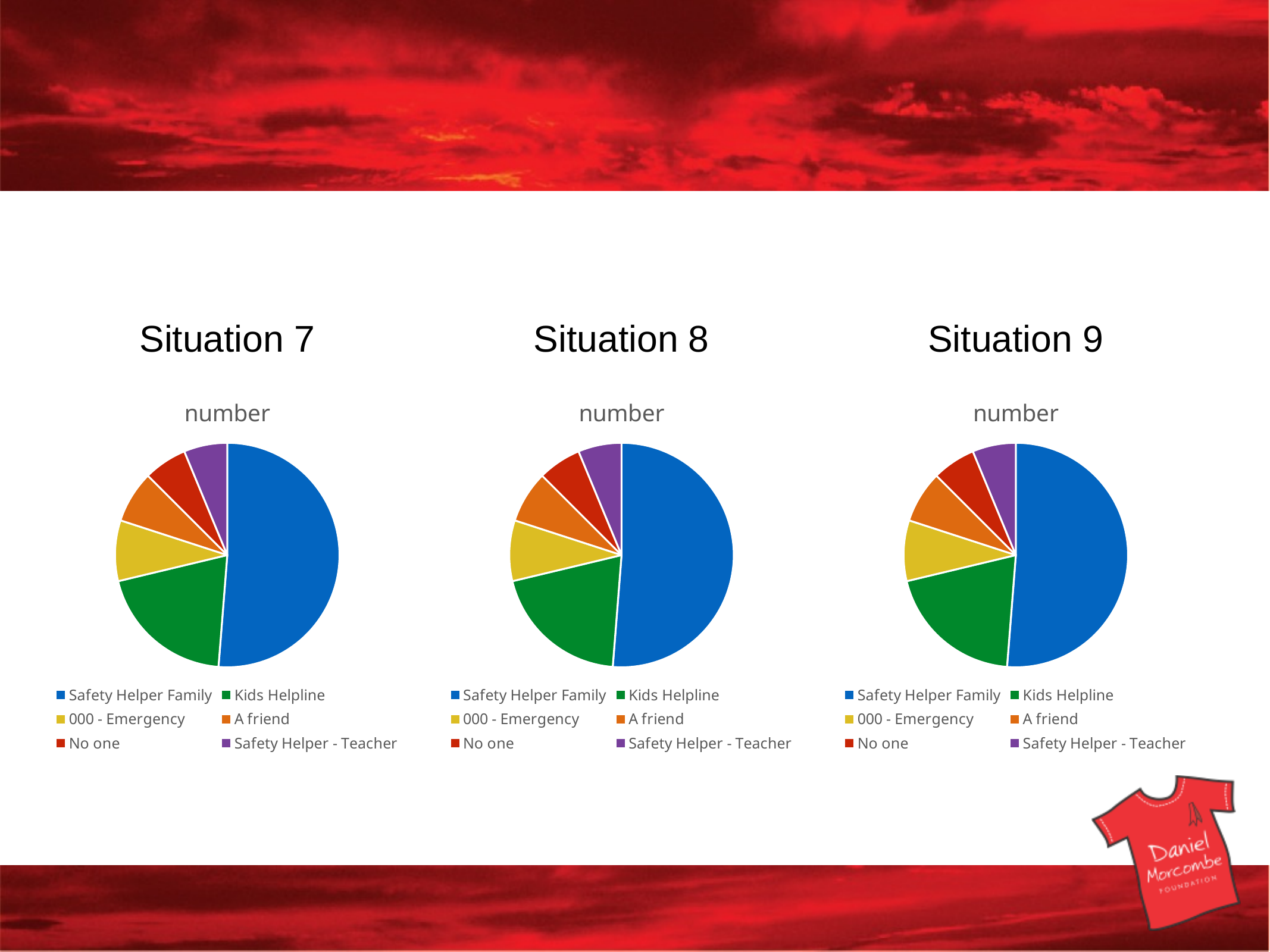
How many slices does the Situation 7 pie chart have? 6 What kind of chart is used for Situation 7? Pie chart In the Situation 7 chart, which slice is larger: Kids Helpline or 000 - Emergency? Kids Helpline In the Situation 7 chart, which category has the largest slice? Safety Helper Family In the Situation 9 chart, what colour represents Kids Helpline? Green How many categories does the legend of the Situation 9 chart list? 6 In the Situation 8 chart, which slice is larger: Safety Helper Family or Kids Helpline? Safety Helper Family In the Situation 9 chart, which category has the largest slice? Safety Helper Family What is the chart title shown above each pie chart? number In the Situation 9 chart, which slice is larger: A friend or Kids Helpline? Kids Helpline In the Situation 8 chart, which category has the largest slice? Safety Helper Family